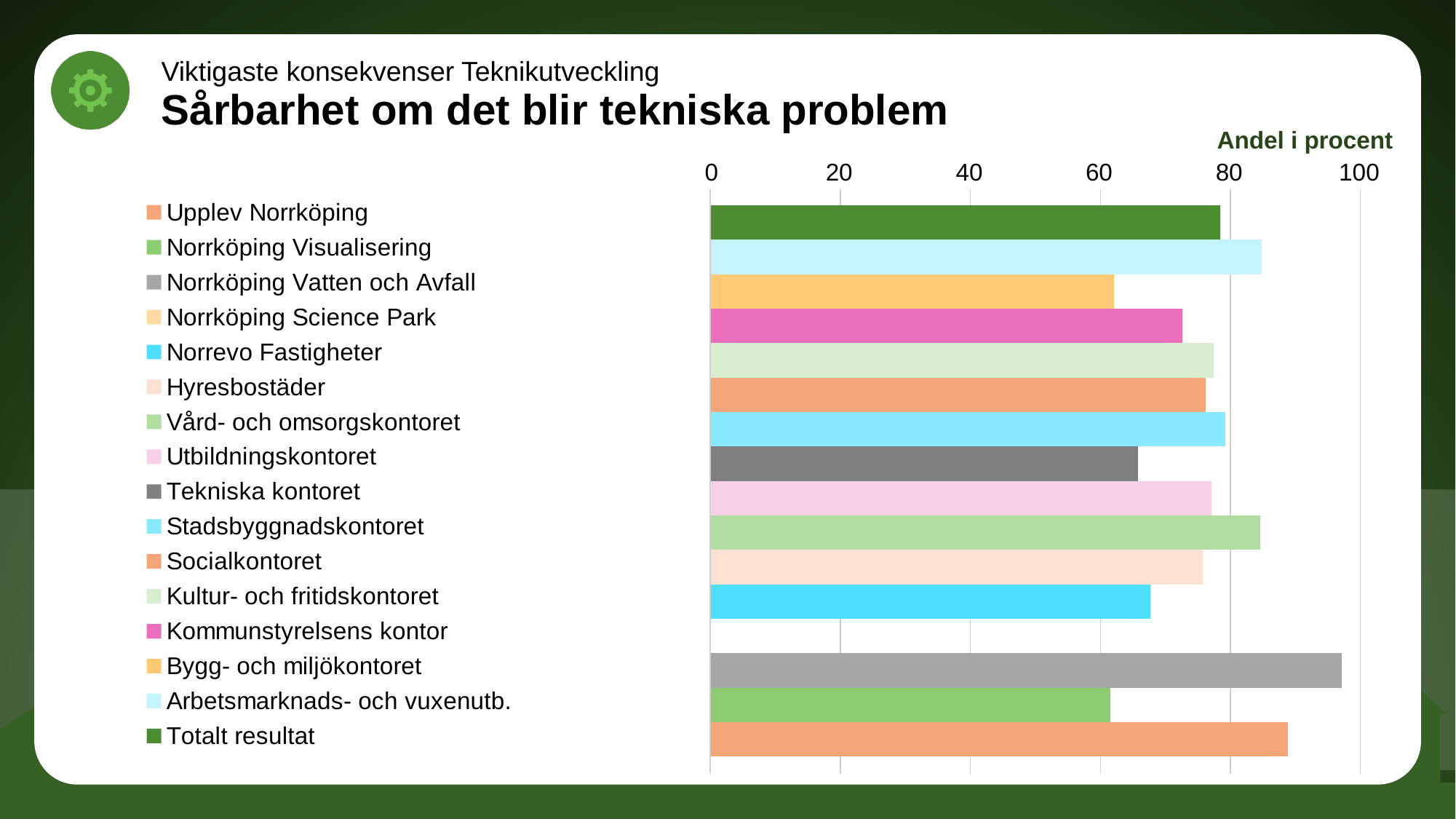
Which is larger, the value for Arbetsmarknads- och vuxenutb. or the value for Bygg- och miljökontoret? Arbetsmarknads- och vuxenutb. How many entries does the chart legend list? 16 Is the value for Norrevo Fastigheter greater or less than 80? less Which category has the highest value in the chart? Norrköping Vatten och Avfall What kind of chart is shown on the slide? bar chart What label is shown above the horizontal axis of the chart? Andel i procent Which is larger, the value for Norrköping Vatten och Avfall or the value for Socialkontoret? Norrköping Vatten och Avfall Is the value for Norrköping Vatten och Avfall greater or less than 80? greater Which is larger, the value for Upplev Norrköping or the value for Tekniska kontoret? Upplev Norrköping Is the value for Bygg- och miljökontoret greater or less than 80? less